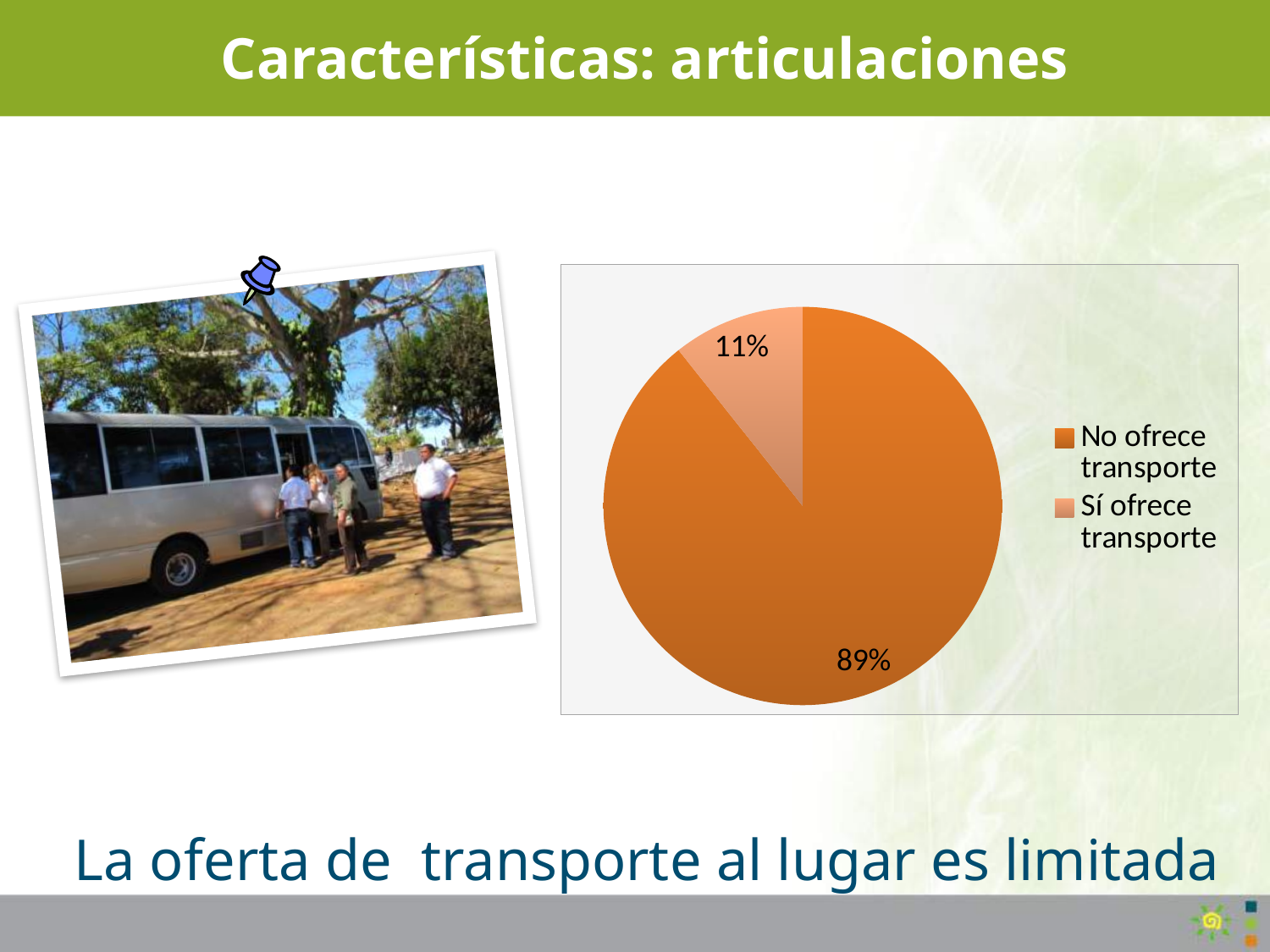
What colour is the slice for "No ofrece transporte"? Orange What kind of chart is shown on the slide? Pie chart What share of the pie does "Sí ofrece transporte" represent? 11% Which is larger, the slice for "No ofrece transporte" or the slice for "Sí ofrece transporte"? No ofrece transporte What is the difference in percentage points between "No ofrece transporte" and "Sí ofrece transporte"? 78 Which category has the smallest slice of the pie? Sí ofrece transporte What share of the pie does "No ofrece transporte" represent? 89% Which category has the largest slice of the pie? No ofrece transporte How many entries does the legend list? 2 How many slices does the pie chart have? 2 Where is the legend positioned relative to the pie? To the right